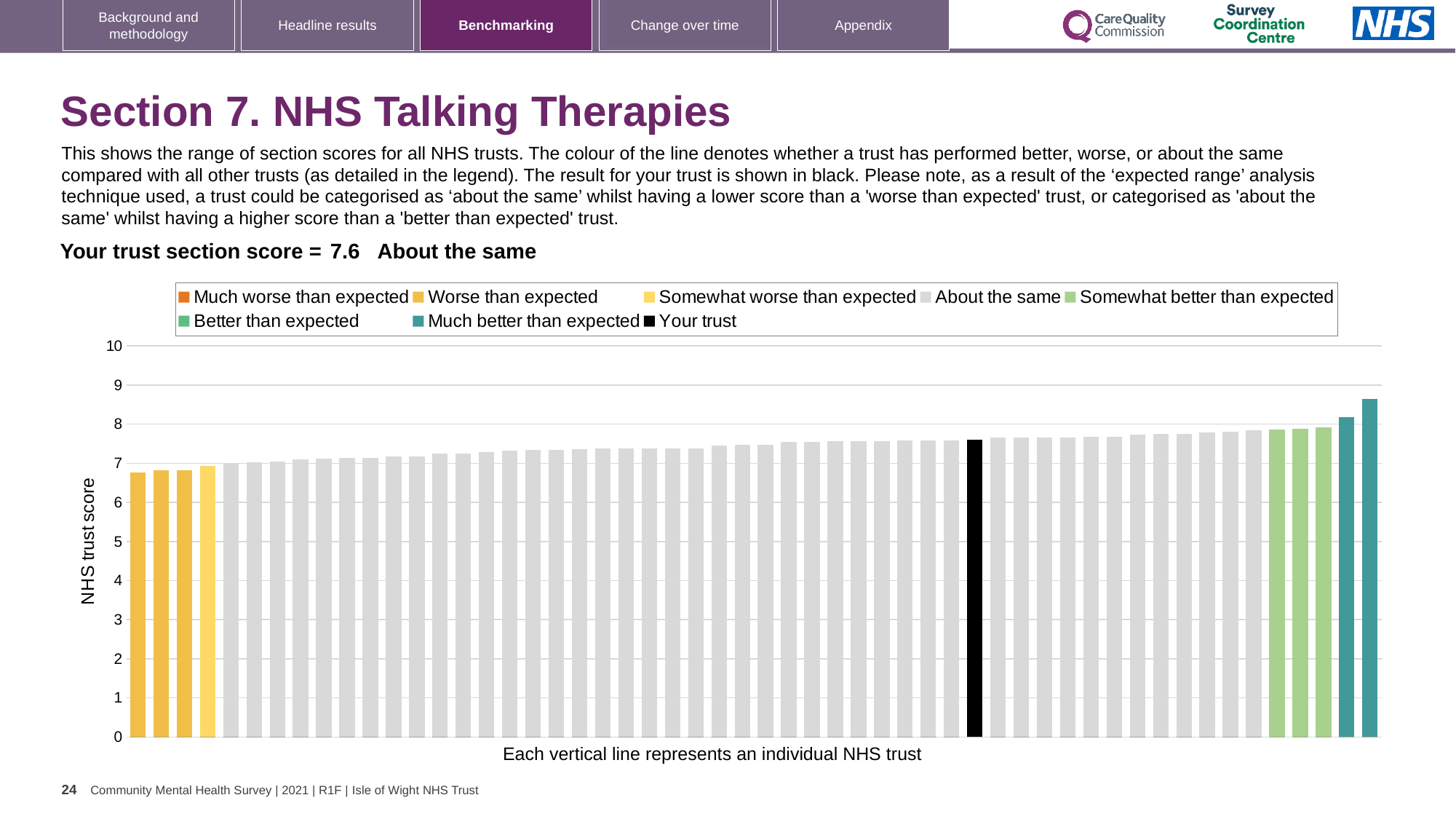
Do the bar values rise or fall from left to right along the x axis? Rise Is the value for the leftmost bar greater or less than 7? less Which legend category does the tallest bar belong to? Much better than expected What is the label on the y axis? NHS trust score What kind of chart is shown on the slide? Bar chart Is the value for your trust greater or less than 7? greater How many entries does the chart legend list? 8 Is the value for the tallest bar greater or less than 8? greater What is the section score for your trust? 7.6 Which category is your trust placed in for this section? About the same How many bars are coloured as 'Much better than expected'? 2 Which is larger, the score for your trust or the score of the leftmost bar? Your trust